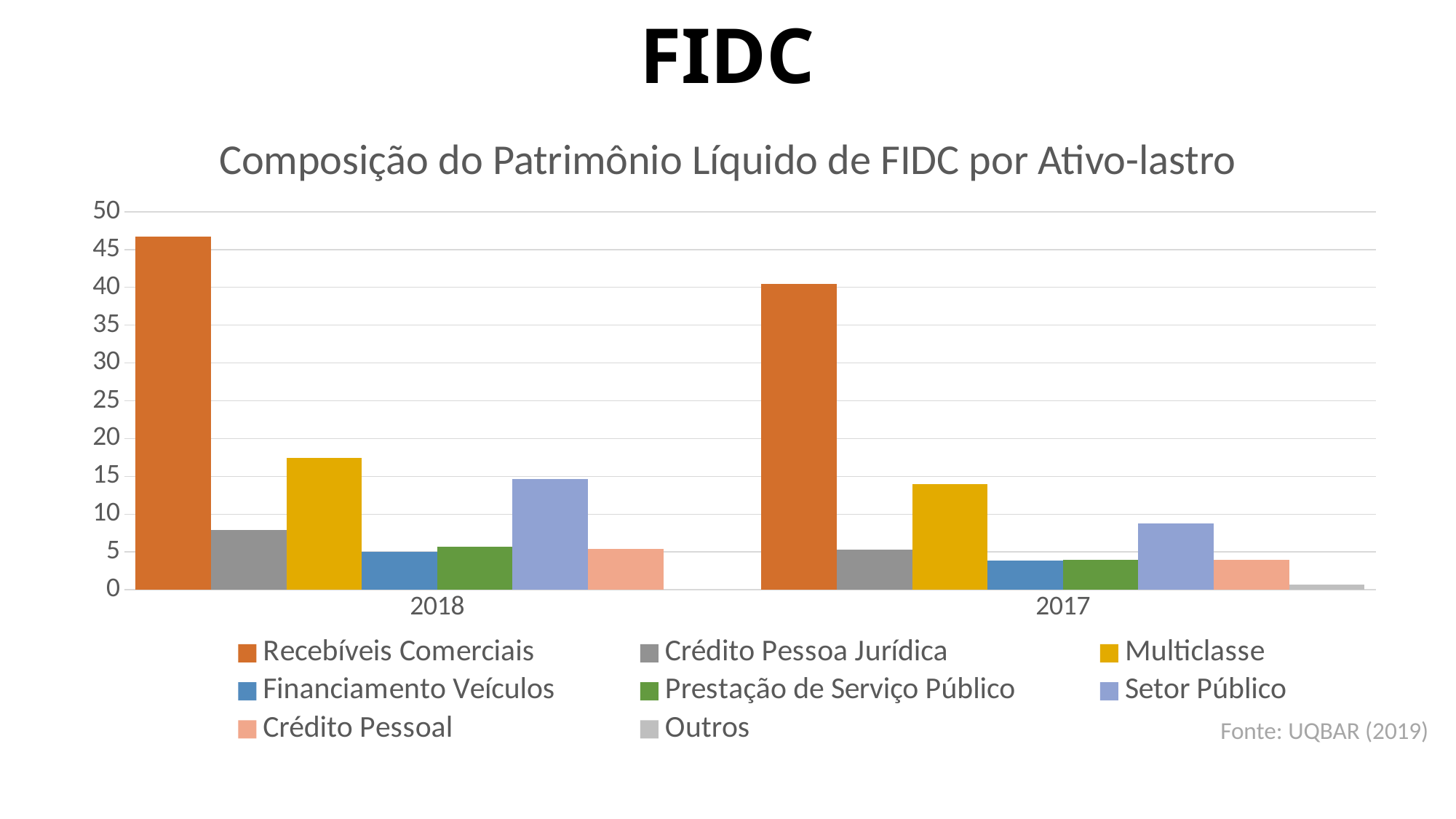
How many year categories are shown on the x axis? 2 What is the title of the chart? Composição do Patrimônio Líquido de FIDC por Ativo-lastro Is the value for Setor Público in 2017 greater or less than 10? less Is the value for Multiclasse in 2018 greater or less than 15? greater Which series has the highest value in 2018? Recebíveis Comerciais In 2018, which is larger: Multiclasse or Setor Público? Multiclasse Which series has the lowest value in 2017? Outros How many series does the legend list? 8 Which series has the highest value in 2017? Recebíveis Comerciais What kind of chart is shown on the slide? bar chart Is the value for Recebíveis Comerciais in 2018 greater or less than 40? greater